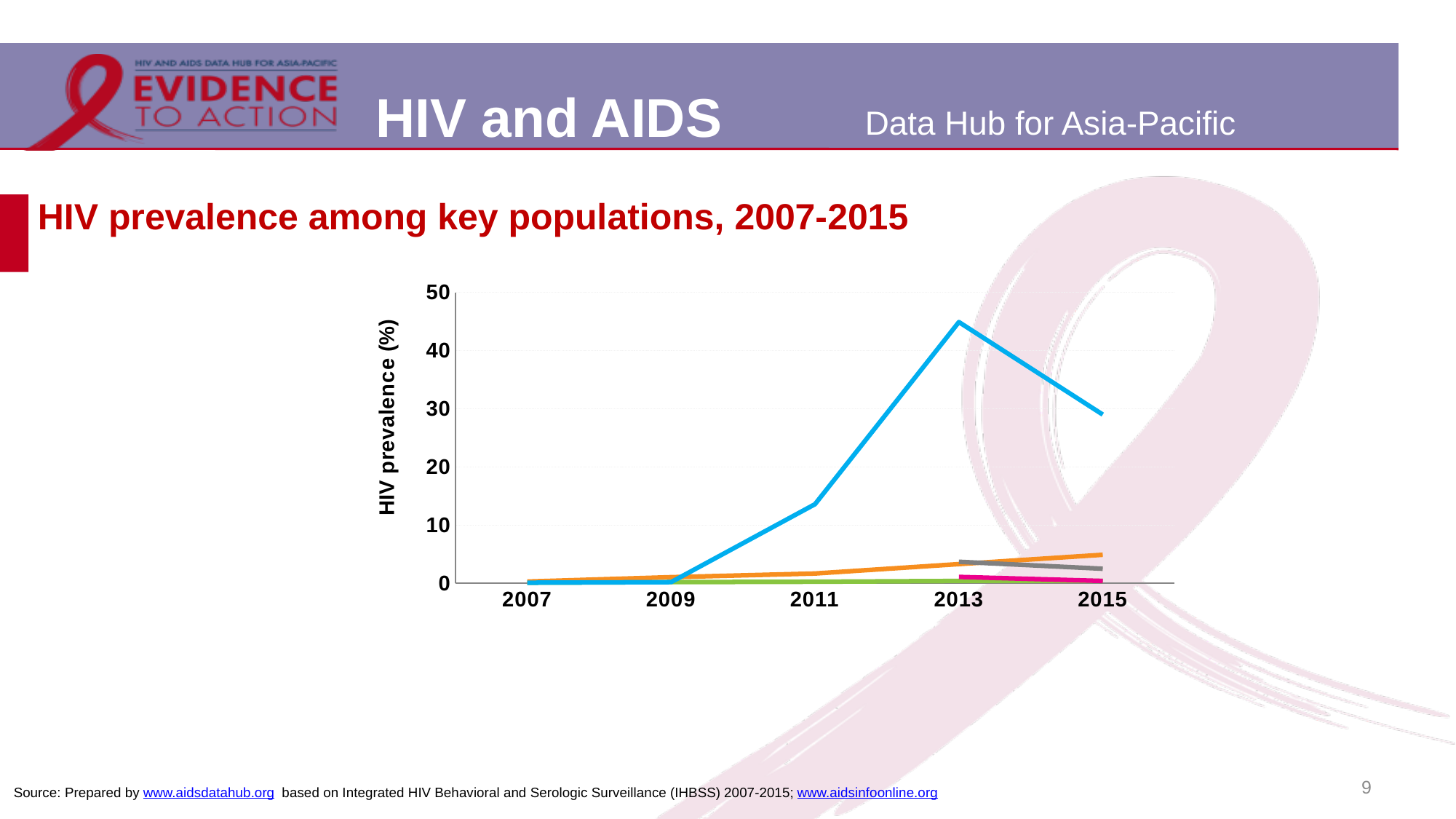
In which year does the blue line reach its highest value? 2013 What is the label of the vertical axis? HIV prevalence (%) Does the blue line rise or fall between 2009 and 2013? rise Which line has the larger value in 2015, the blue line or the orange line? blue line How many years are labelled on the x axis? 5 Is the value of the blue line in 2015 greater or less than 20? greater What is the title of the chart on the slide? HIV prevalence among key populations, 2007-2015 What kind of chart is shown on the slide? line chart What is the highest value shown on the vertical axis? 50 Is the value of the blue line in 2013 greater or less than 40? greater Is the value of the blue line in 2009 greater or less than 10? less